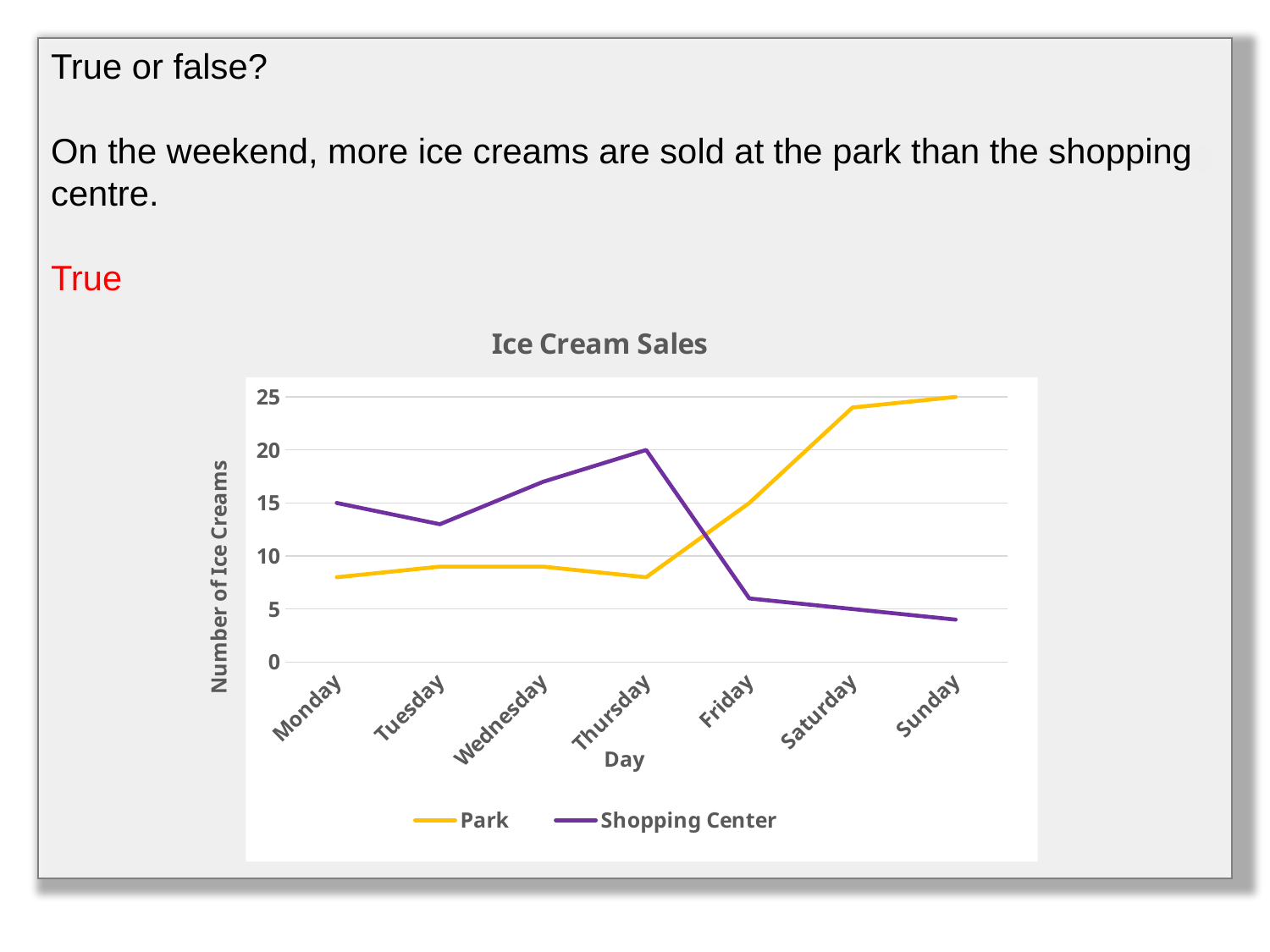
On which day is the Park series highest? Sunday How many series does the legend list? 2 On which day is the Shopping Center series lowest? Sunday Is the value for Park on Saturday greater or less than 20? greater What type of chart is shown on the slide? Line chart What is the value for Park on Sunday? 25 What is the title of the chart? Ice Cream Sales How many days are shown on the x axis? 7 What is the value for Shopping Center on Thursday? 20 What is the value for Shopping Center on Monday? 15 Does the Shopping Center series rise or fall from Thursday to Sunday? Fall On Saturday, which series has the larger value, Park or Shopping Center? Park